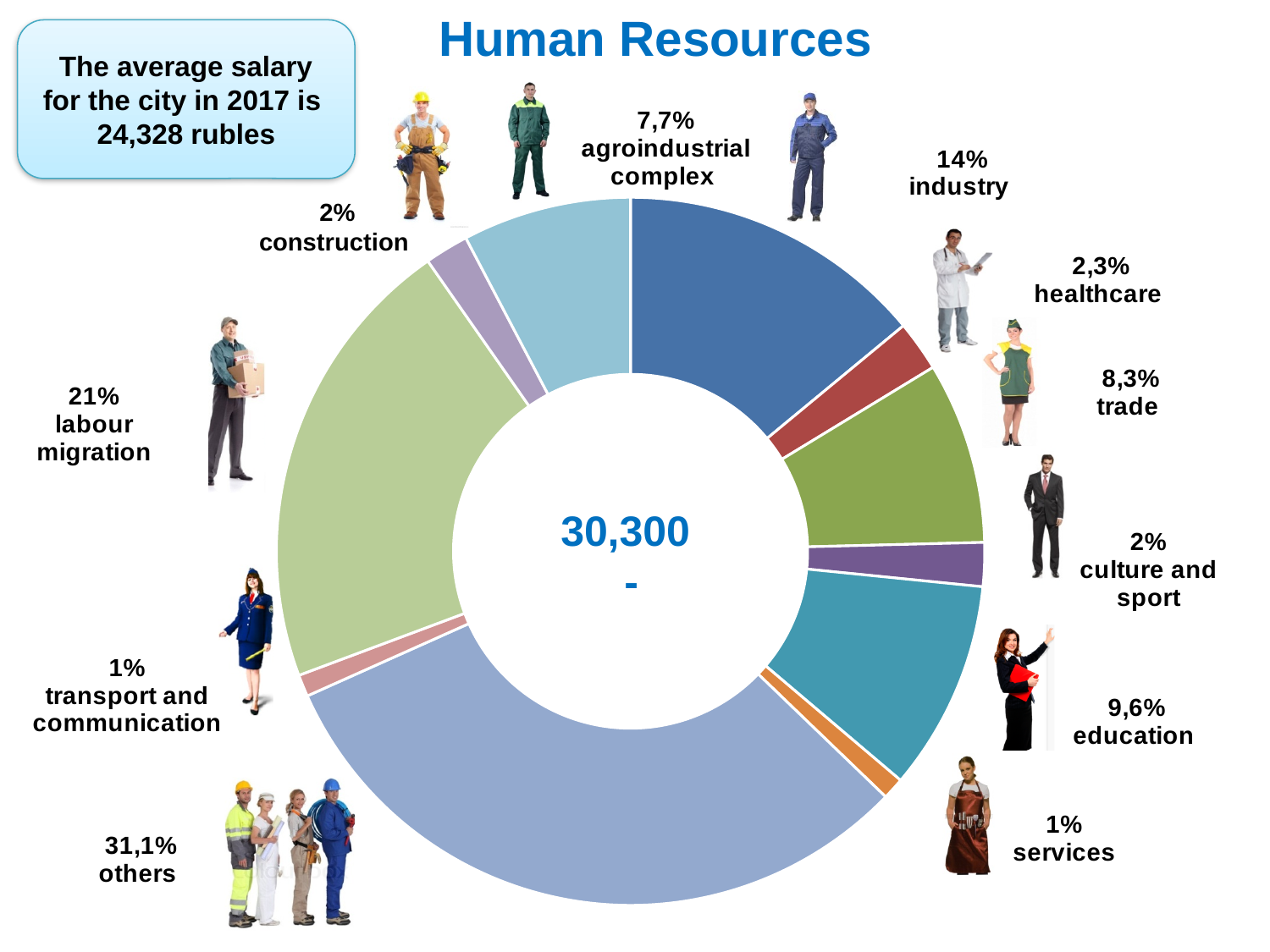
How many categories are shown in the chart? 11 What is the value shown for education? 9,6% What is the difference between the shares of industry and trade? 5,7% What share of the chart does industry account for? 14% What is the combined share of education and services? 10,6% What is the value shown for the agroindustrial complex? 7,7% Which category has a larger share, trade or healthcare? trade Which category has the largest share of the chart? others What percentage is shown for labour migration? 21% What number is printed in the centre of the chart? 30,300 What kind of chart is shown on the slide? pie chart (donut) What is the title of the chart? Human Resources